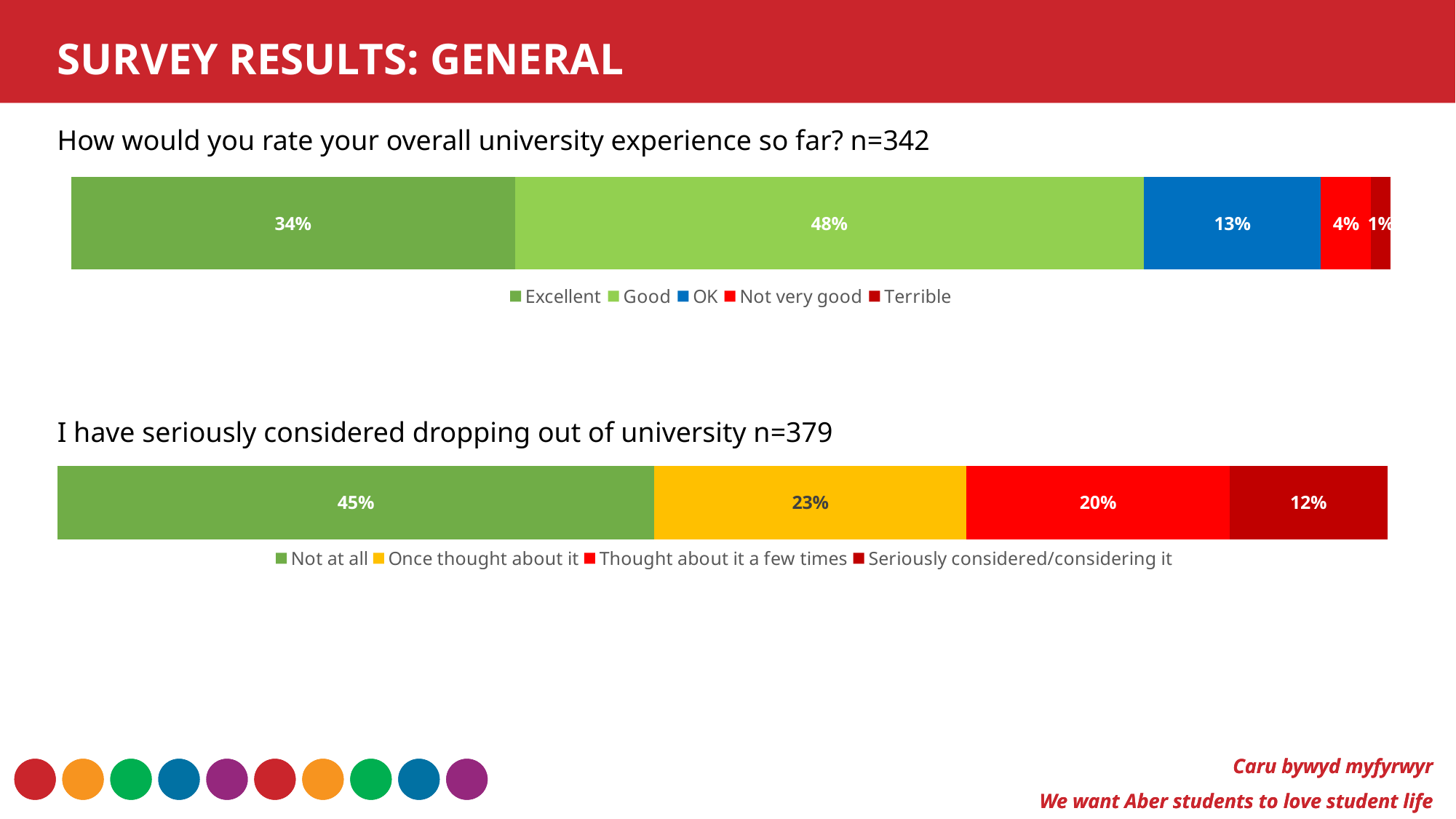
In the chart 'How would you rate your overall university experience so far?', what percentage of respondents answered 'Excellent'? 34% In the chart 'How would you rate your overall university experience so far?', which response has the largest share? Good In the chart 'How would you rate your overall university experience so far?', what percentage of respondents answered 'Good'? 48% What kind of chart is used for 'I have seriously considered dropping out of university'? Stacked bar chart In the chart 'I have seriously considered dropping out of university', which is larger: 'Once thought about it' or 'Thought about it a few times'? Once thought about it In the chart 'How would you rate your overall university experience so far?', which response has the smallest share? Terrible In the chart 'I have seriously considered dropping out of university', how many percentage points higher is 'Not at all' than 'Once thought about it'? 22 In the chart 'I have seriously considered dropping out of university', what percentage of respondents answered 'Not at all'? 45% In the chart 'I have seriously considered dropping out of university', what percentage of respondents answered 'Seriously considered/considering it'? 12% In the chart 'How would you rate your overall university experience so far?', how many series does the legend list? 5 In the chart 'I have seriously considered dropping out of university', how many series does the legend list? 4 In the chart 'How would you rate your overall university experience so far?', how many percentage points higher is 'Good' than 'OK'? 35